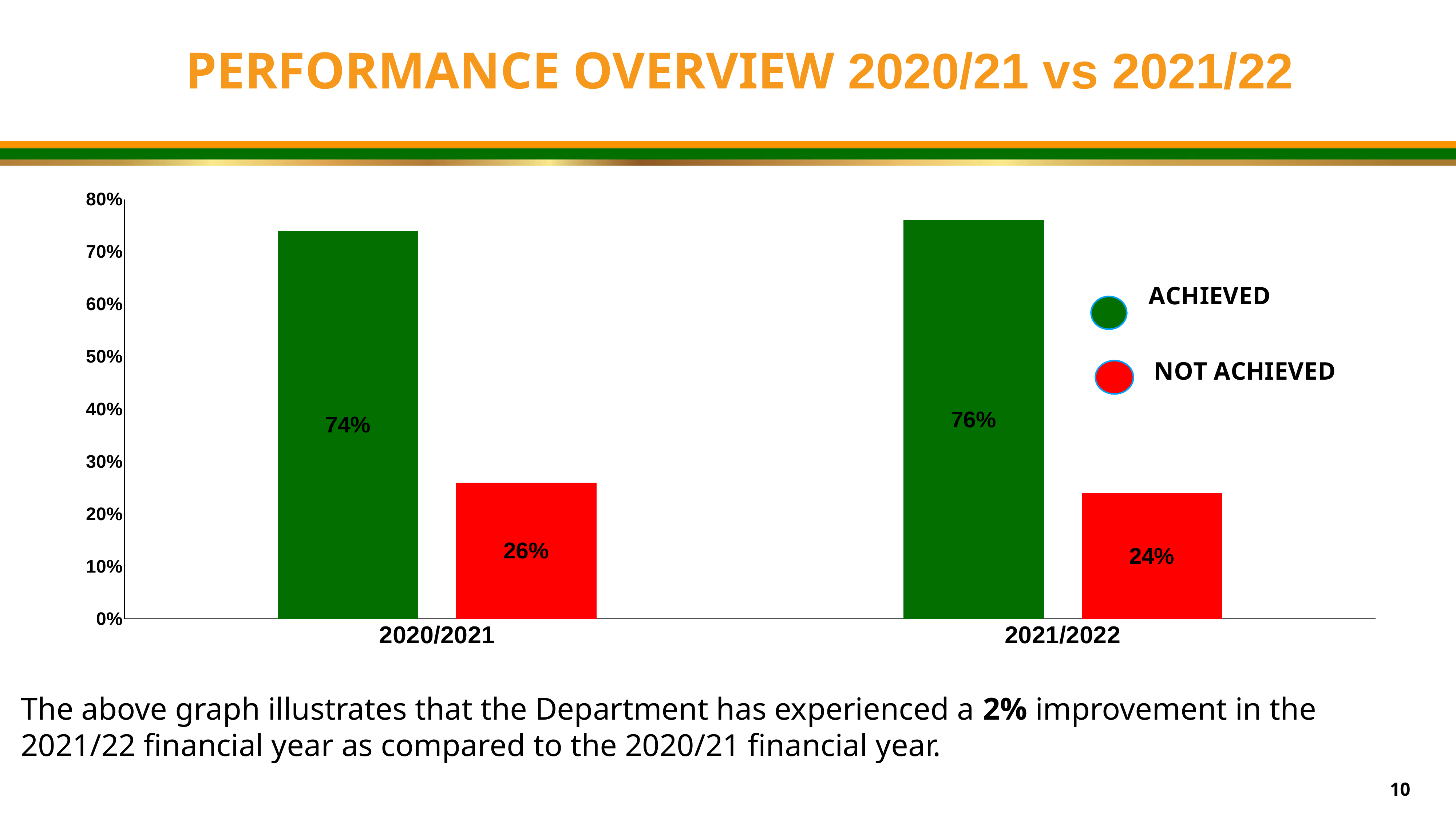
What type of chart is shown on the slide? Bar chart What percentage was not achieved in 2021/2022? 24% How many years are shown on the x axis? 2 What percentage was achieved in 2020/2021? 74% What percentage was achieved in 2021/2022? 76% Which bar is the highest on the chart? Achieved in 2021/2022 (76%) Which year has the higher achieved percentage? 2021/2022 What colour represents 'NOT ACHIEVED' in the legend? Red What is the difference between the achieved percentage in 2021/2022 and in 2020/2021? 2% What is the difference between the achieved and not achieved percentages in 2020/2021? 48% What percentage was not achieved in 2020/2021? 26% Which bar is the lowest on the chart? Not achieved in 2021/2022 (24%)